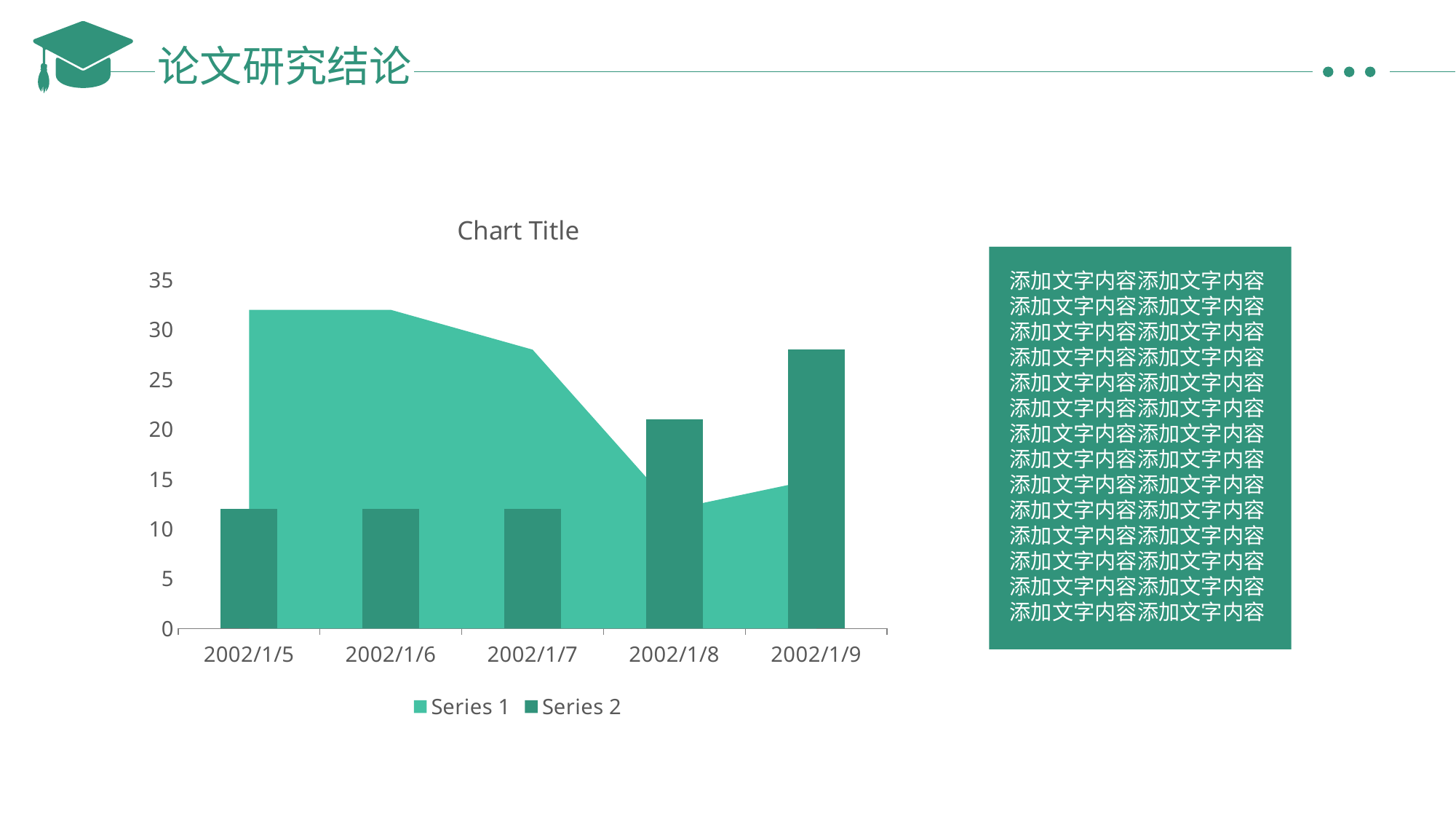
What is the title of the chart? Chart Title Which is larger at 2002/1/8, Series 1 or Series 2? Series 2 Does Series 1 generally rise or fall from 2002/1/5 to 2002/1/8? fall Is the Series 2 value for 2002/1/5 greater or less than 15? less Which category has the highest Series 2 bar? 2002/1/9 Is the Series 1 value for 2002/1/8 greater or less than 15? less How many series does the legend list? 2 Which is larger at 2002/1/6, Series 1 or Series 2? Series 1 How many categories are shown on the x axis? 5 Is the Series 2 value for 2002/1/9 greater or less than 25? greater What kind of chart is this? A combination of an area chart (Series 1) and a bar chart (Series 2)